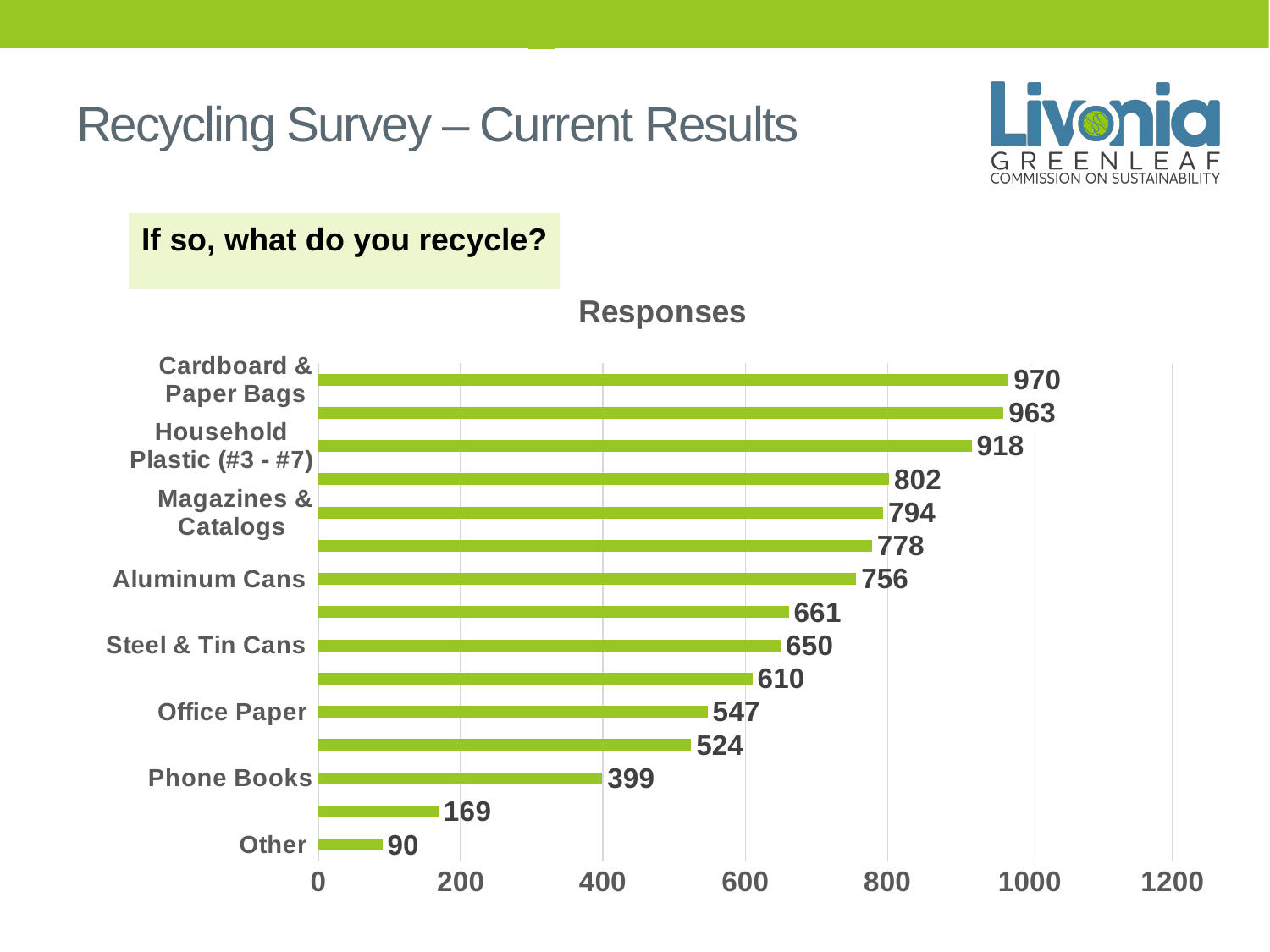
Which category has the lowest number of responses? Other What kind of chart is shown on the slide? bar chart What is the difference between the values for Magazines & Catalogs and Office Paper? 247 What is the value for Aluminum Cans? 756 Which is larger, the value for Steel & Tin Cans or the value for Aluminum Cans? Aluminum Cans Which category has the highest number of responses? Cardboard & Paper Bags How many bars are plotted in the chart? 15 What is the title of the chart? Responses What is the value for Household Plastic (#3 - #7)? 918 Is the value for Office Paper greater or less than 600? less What is the value for Cardboard & Paper Bags? 970 What is the value for Phone Books? 399